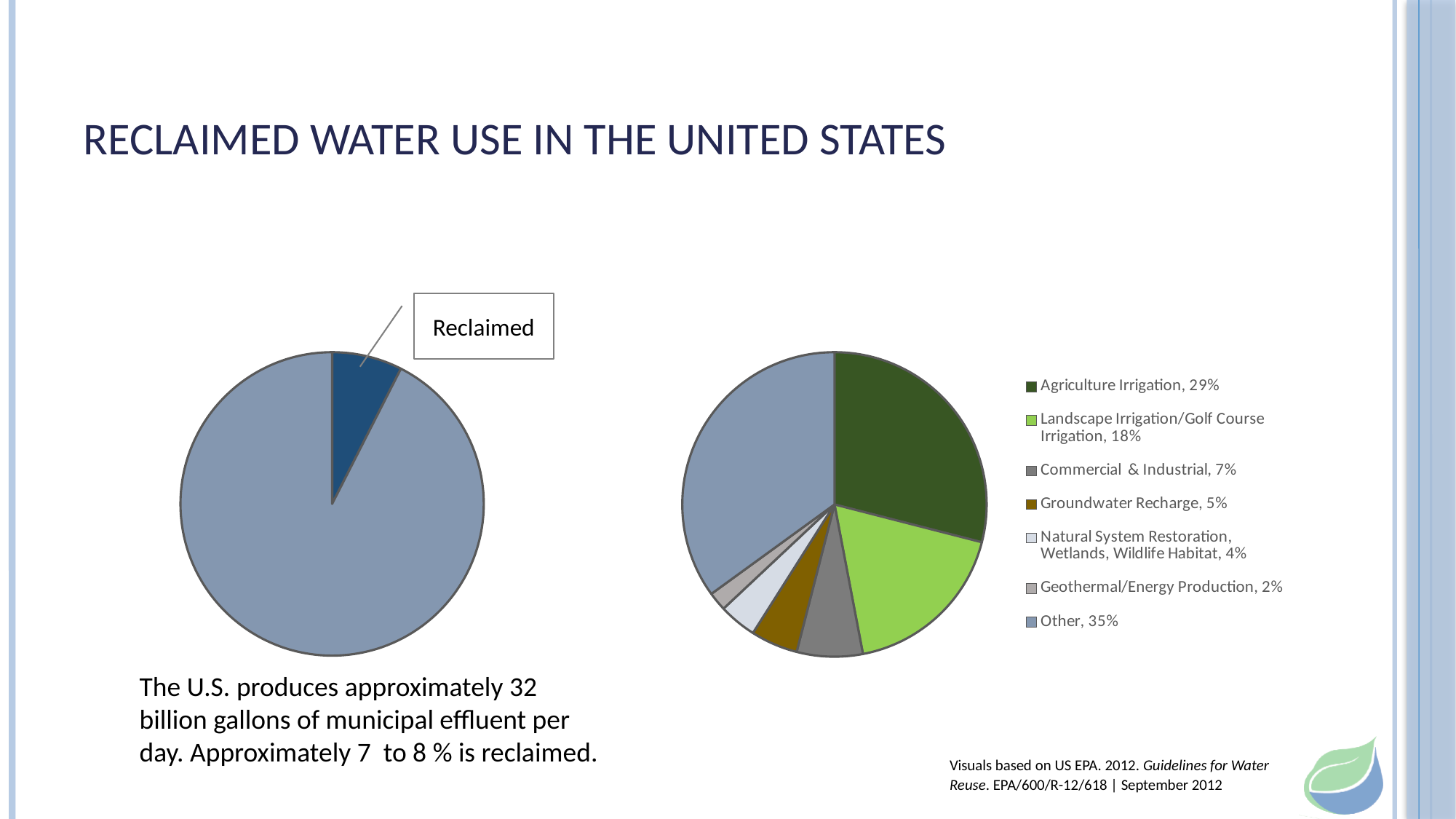
In the pie chart on the right, how many percentage points larger is Agriculture Irrigation than Landscape Irrigation/Golf Course Irrigation? 11% In the pie chart on the right, what percentage is Agriculture Irrigation? 29% In the pie chart on the right, which category has the largest share? Other In the pie chart on the left, what is the label of the small dark blue slice? Reclaimed What kind of chart is the chart on the right of the slide? pie chart In the pie chart on the right, what percentage is Groundwater Recharge? 5% In the pie chart on the right, what percentage is Geothermal/Energy Production? 2% What kind of chart is the chart on the left of the slide? pie chart In the pie chart on the right, which category has the smallest share? Geothermal/Energy Production In the pie chart on the right, which is larger: Commercial & Industrial or Natural System Restoration, Wetlands, Wildlife Habitat? Commercial & Industrial How many categories does the legend of the pie chart on the right list? 7 In the pie chart on the right, what percentage is Landscape Irrigation/Golf Course Irrigation? 18%